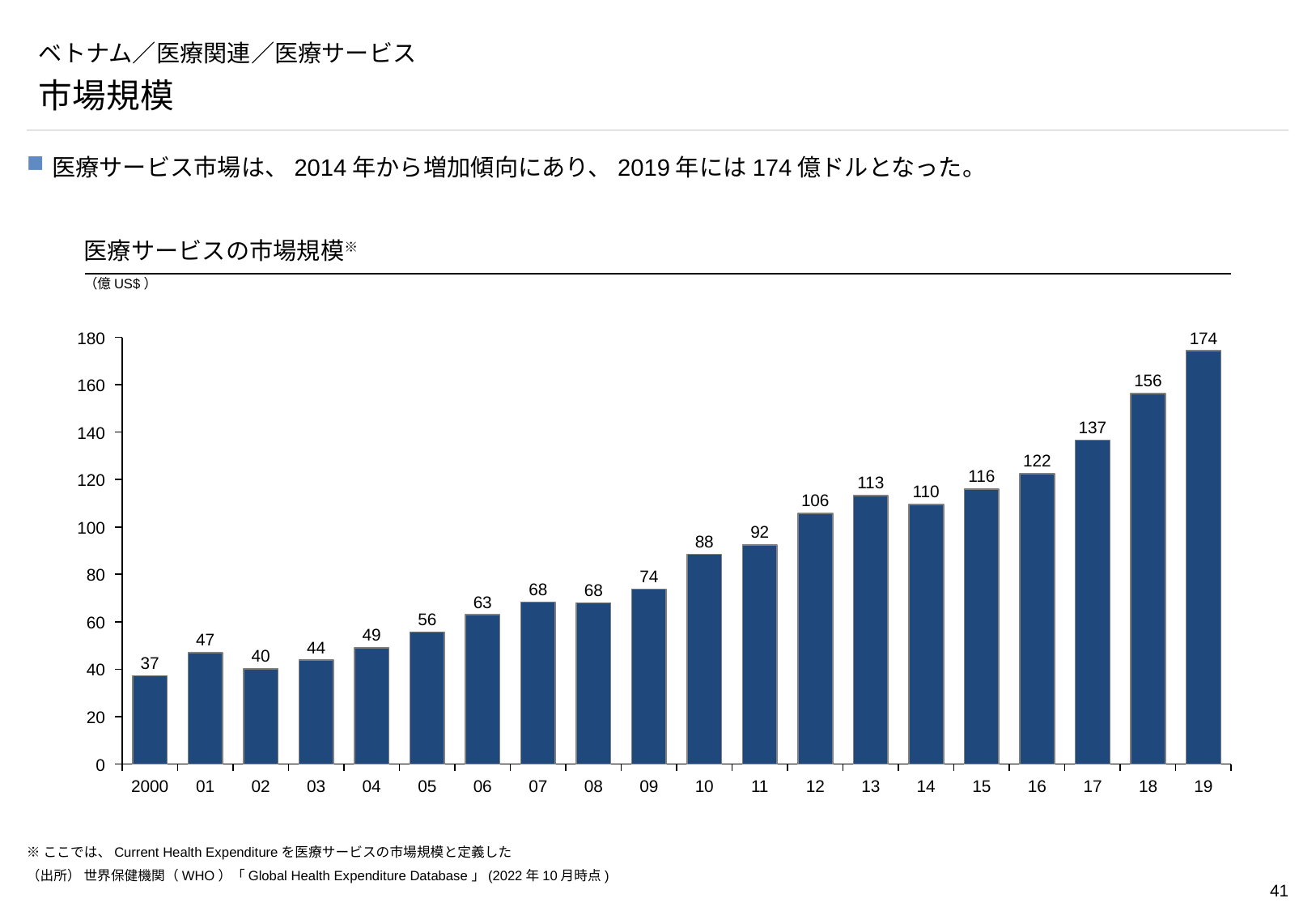
Is the value for 2017 greater or less than 120? greater What is the difference between the values for 2019 and 2018? 18 What is the value for 2019? 174 Which is larger, the value for 2013 or the value for 2014? 2013 What is the value for 2000? 37 What unit is shown for the chart's values? 億US$ Do the values generally rise or fall from 2014 to 2019? rise How many bars are shown in the chart? 20 Which year has the highest value? 19 What is the value for 2014? 110 Which year has the lowest value? 2000 What kind of chart is shown on the slide? bar chart